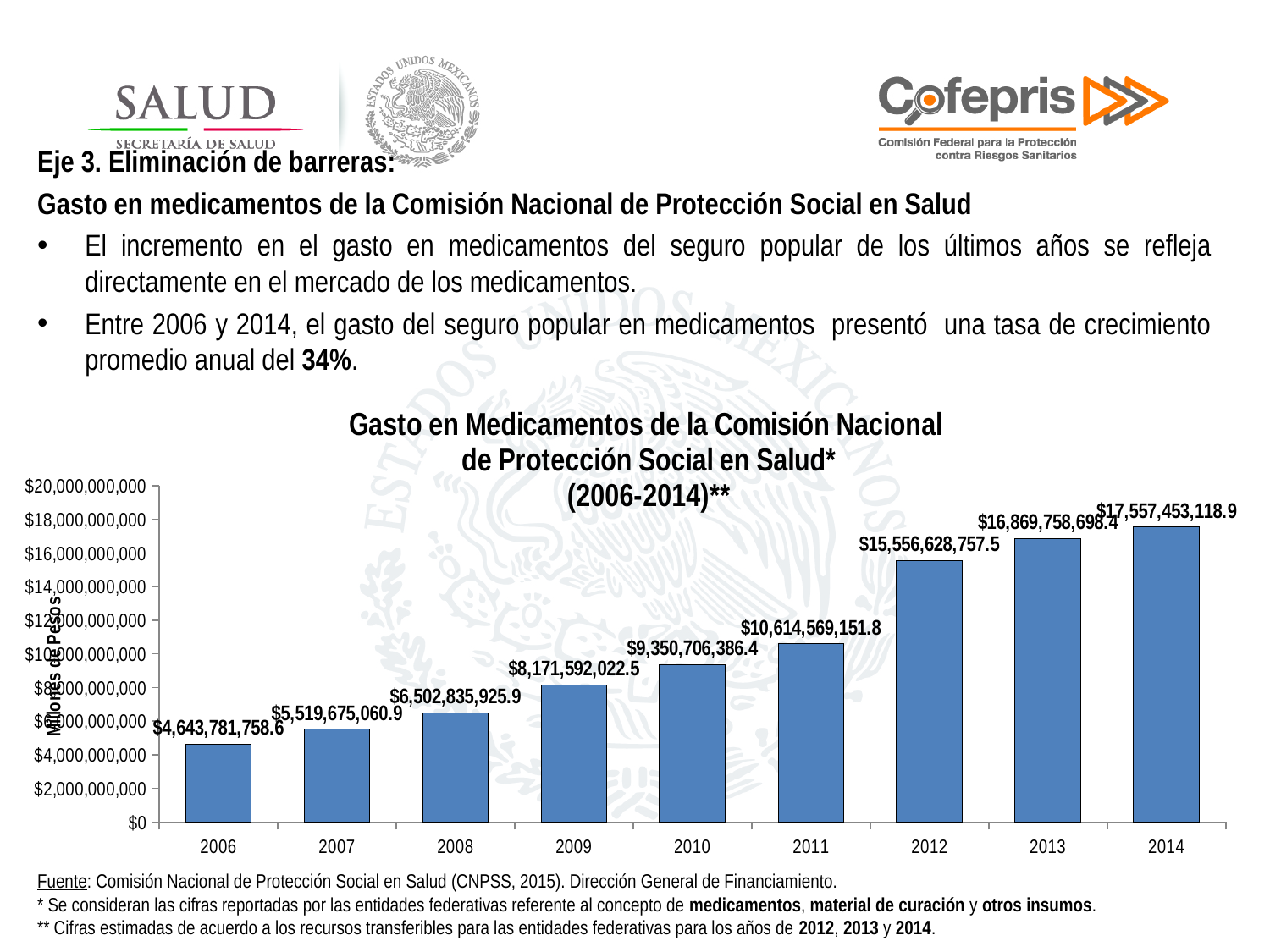
What is the value for 2014? $17,557,453,118.9 What is the difference between the values for 2012 and 2011? $4,942,059,605.7 Which is larger, the value for 2010 or the value for 2011? 2011 What is the value for 2009? $8,171,592,022.5 Which year has the lowest value? 2006 What is the value for 2006? $4,643,781,758.6 What type of chart is shown on the slide? Bar chart Is the value for 2010 greater or less than $8,000,000,000? greater Which year has the highest value? 2014 How many years are shown on the x axis? 9 What is the difference between the values for 2007 and 2006? $875,893,302.3 What is the value for 2012? $15,556,628,757.5